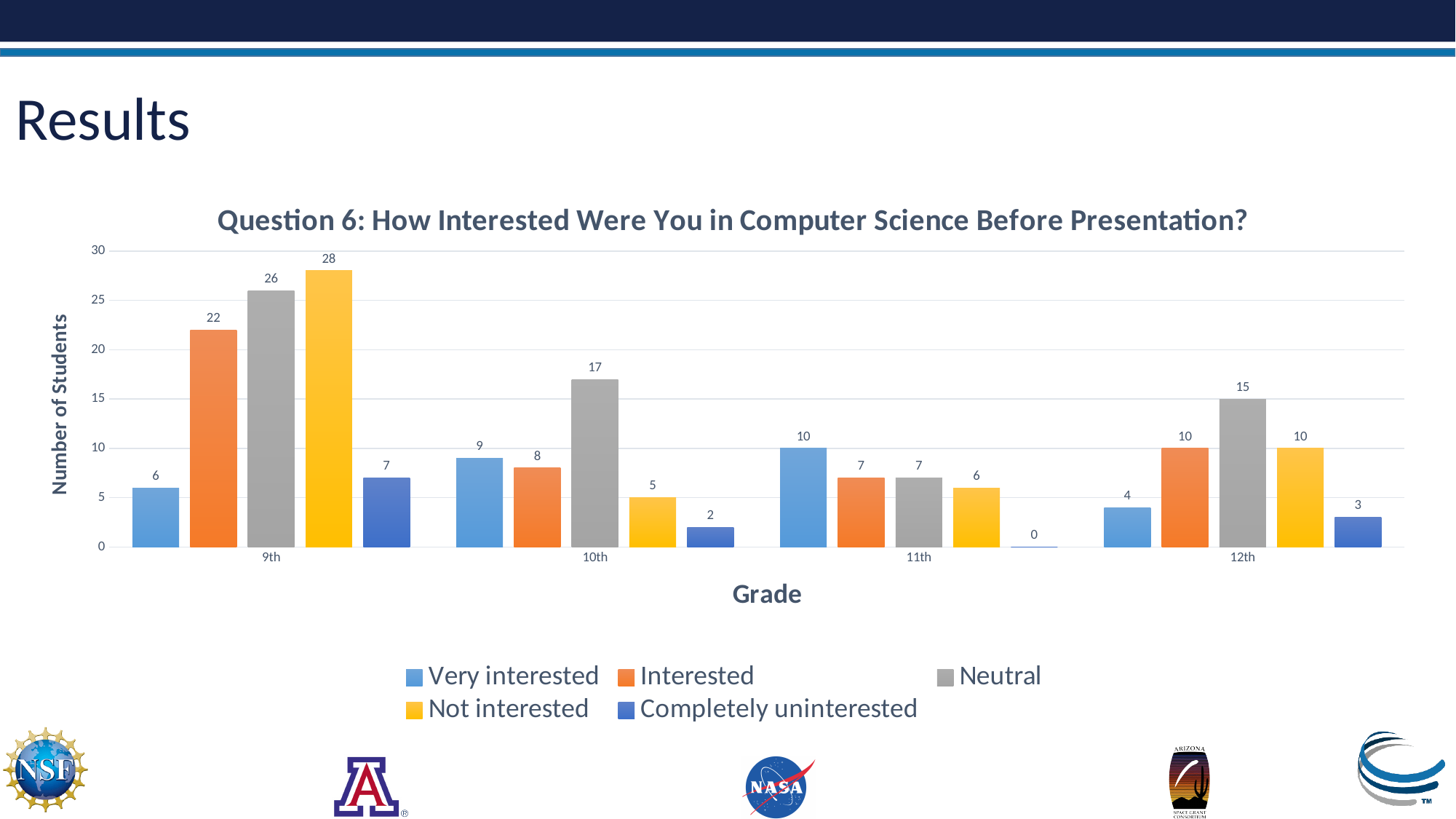
What is the difference between the Neutral and Very interested values in 9th grade? 20 How does the Not interested value change from 9th grade to 12th grade? It falls How many grade categories are shown on the x axis? 4 Which is larger in 12th grade: Neutral or Not interested? Neutral How many series does the legend list? 5 Which grade has the lowest Interested value? 11th What is the value for Neutral in 10th grade? 17 What is the value for Completely uninterested in 11th grade? 0 Which grade has the highest Very interested value? 11th What kind of chart is shown? Bar chart What is the label of the y axis? Number of Students What is the value for Not interested in 9th grade? 28